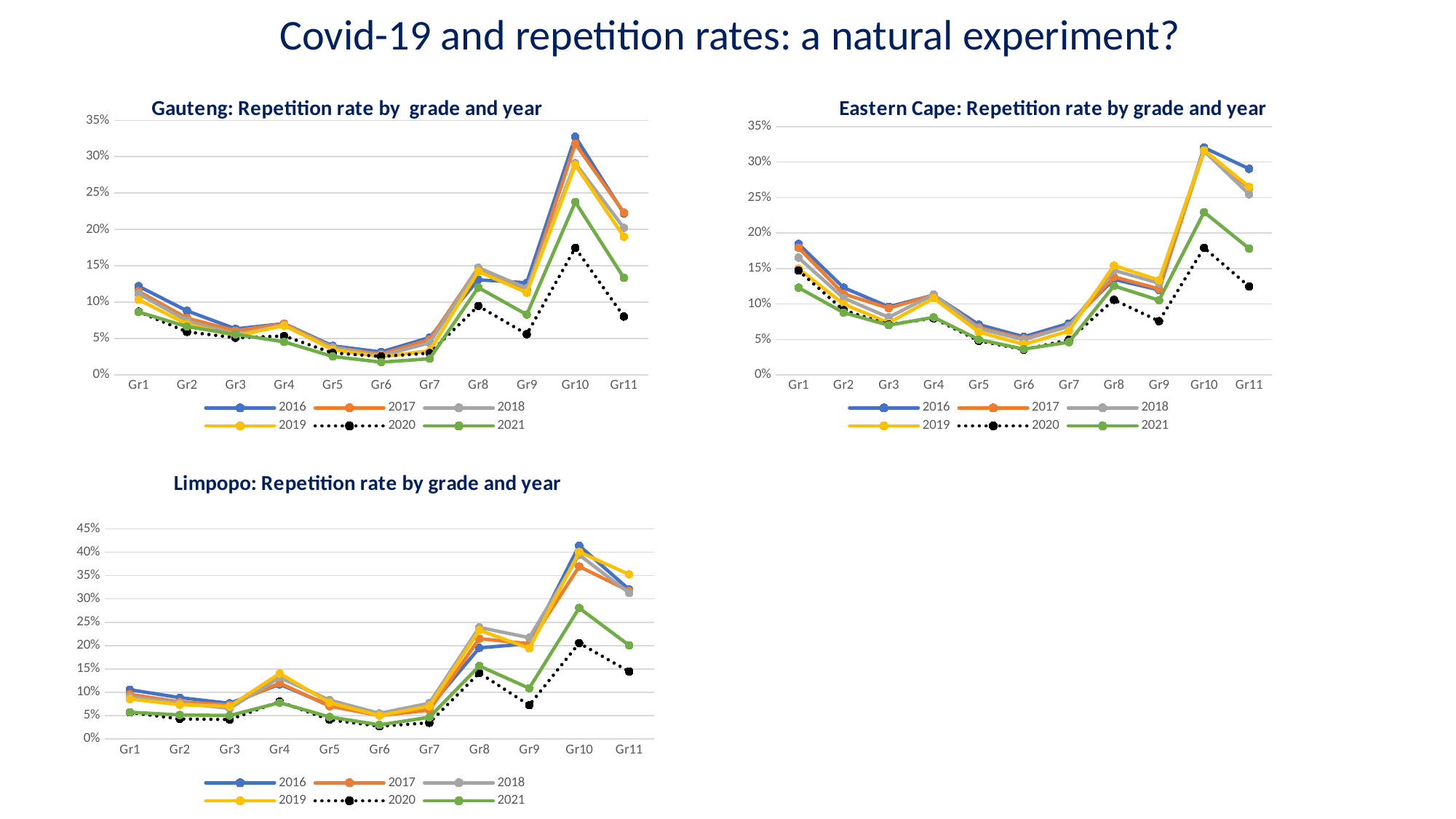
In the Limpopo chart, is the 2016 value for Gr10 greater or less than 40%? greater In the Gauteng chart, does the 2020 series rise or fall from Gr10 to Gr11? fall What kind of chart is the Gauteng chart? line chart In the Gauteng chart, which grade has the highest repetition rate for 2016? Gr10 How many grades are shown on the x axis of the Limpopo chart? 11 Which year is drawn as a dotted black line in the legends? 2020 How many series does the legend of the Eastern Cape chart list? 6 In the Eastern Cape chart, is the 2020 value for Gr11 greater or less than 15%? less What is the title of the chart in the bottom-left of the slide? Limpopo: Repetition rate by grade and year In the Limpopo chart, which is larger at Gr10: the 2016 value or the 2020 value? 2016 In the Gauteng chart, is the 2020 value for Gr10 greater or less than 20%? less In the Eastern Cape chart, which grade has the lowest repetition rate for 2021? Gr6